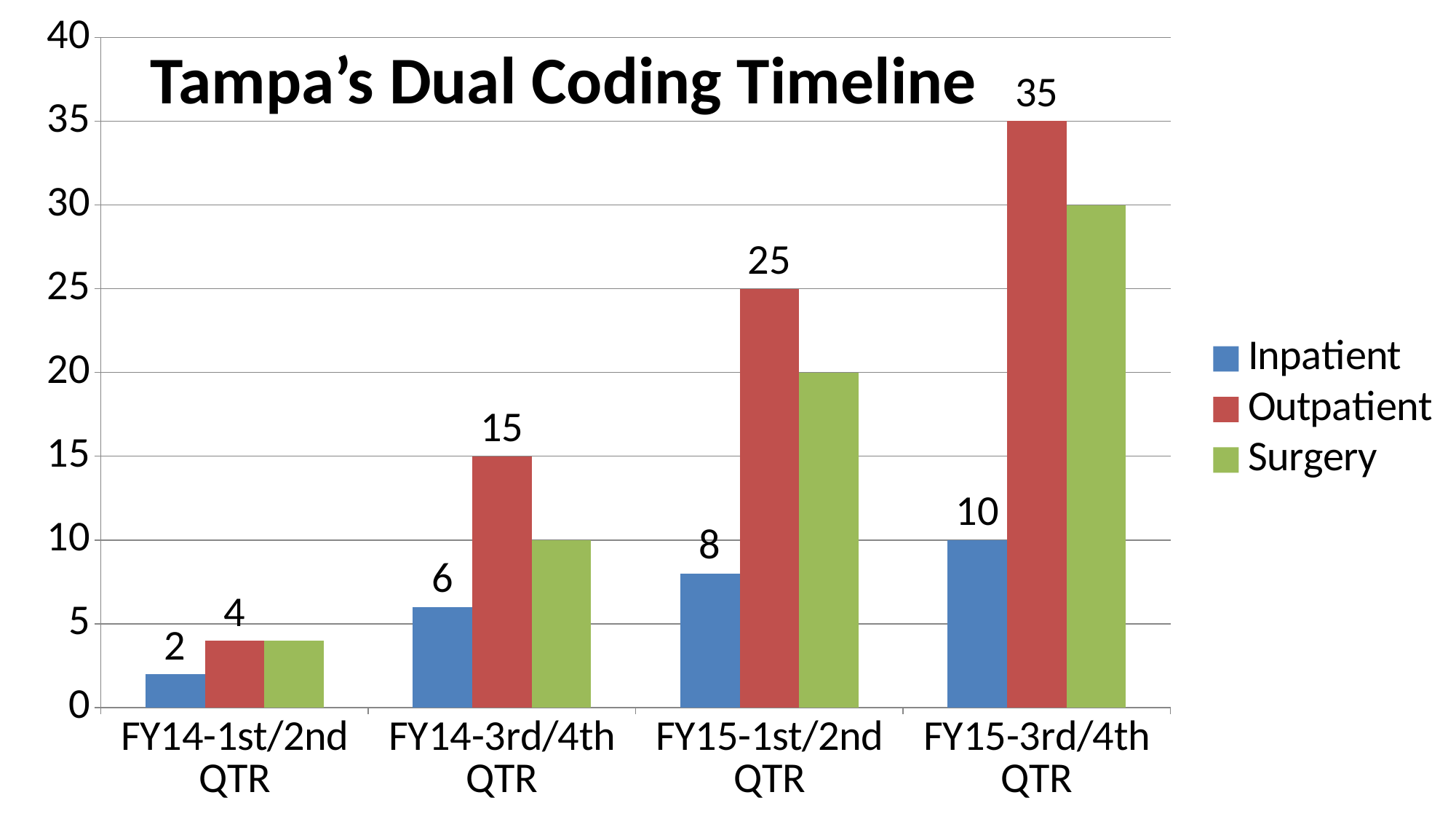
Which quarter has the highest Outpatient value? FY15-3rd/4th QTR What is the Inpatient value for FY14-3rd/4th QTR? 6 What kind of chart is shown on the slide? bar chart How many series does the legend list? 3 Which quarter has the lowest Inpatient value? FY14-1st/2nd QTR What is the Outpatient value for FY15-3rd/4th QTR? 35 What is the Outpatient value for FY15-1st/2nd QTR? 25 Do the Outpatient values rise or fall from FY14-1st/2nd QTR to FY15-3rd/4th QTR? rise Is the Surgery value for FY15-1st/2nd QTR greater or less than 15? greater How many quarter categories are shown on the x axis? 4 What is the difference between the Outpatient values for FY15-1st/2nd QTR and FY14-3rd/4th QTR? 10 Which is larger: the Inpatient value for FY15-3rd/4th QTR or the Outpatient value for FY14-3rd/4th QTR? Outpatient for FY14-3rd/4th QTR